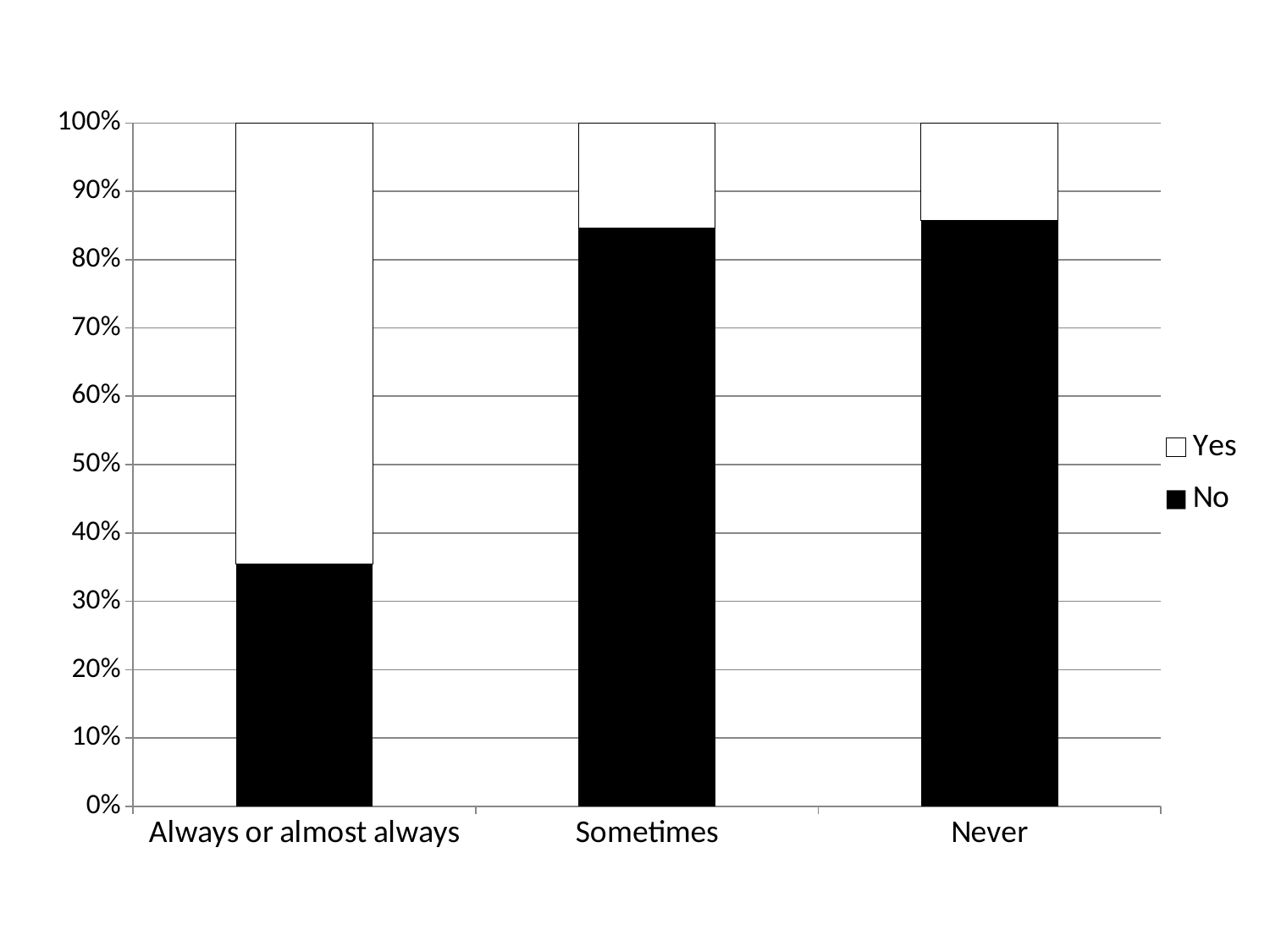
Which colour represents the No series in the legend? black Is the No value for Always or almost always greater or less than 30%? greater Which category has the lowest value for the No series? Always or almost always Is the No value for Never greater or less than 90%? less How many categories are shown on the x axis? 3 How many series does the legend list? 2 What is the total height of the stacked bar for Sometimes? 100% Is the No value for Sometimes greater or less than 80%? greater Which is larger, the No value for Always or almost always or the No value for Sometimes? Sometimes What kind of chart is shown on the slide? stacked bar chart Which category has the highest value for the Yes series? Always or almost always